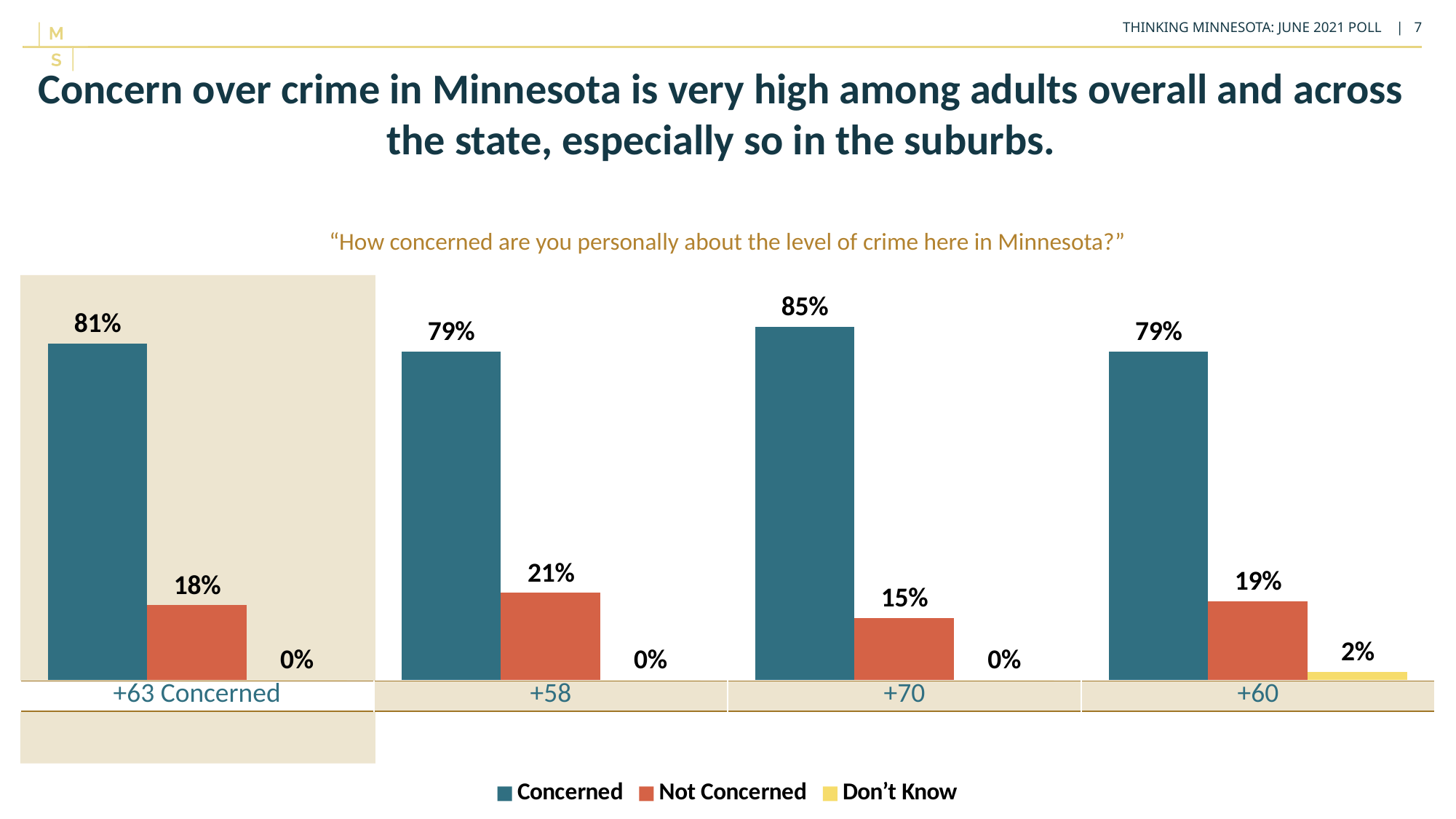
What is the Don't Know value for the group labelled "+60"? 2% What is the difference between the Concerned and Not Concerned values in the group labelled "+70"? 70% What kind of chart is shown on the slide? bar chart What is the Not Concerned value for the group labelled "+58"? 21% What colour are the Not Concerned bars? red/orange What is the Concerned value for the group labelled "+63 Concerned"? 81% How many series does the legend list? 3 How many groups of bars are shown along the x axis? 4 Which group has the highest Concerned value? +70 What is the Concerned value for the rightmost group of bars? 79% Which is larger: the Not Concerned value for the group labelled "+58" or for the group labelled "+60"? +58 Which group has the lowest Not Concerned value? +70